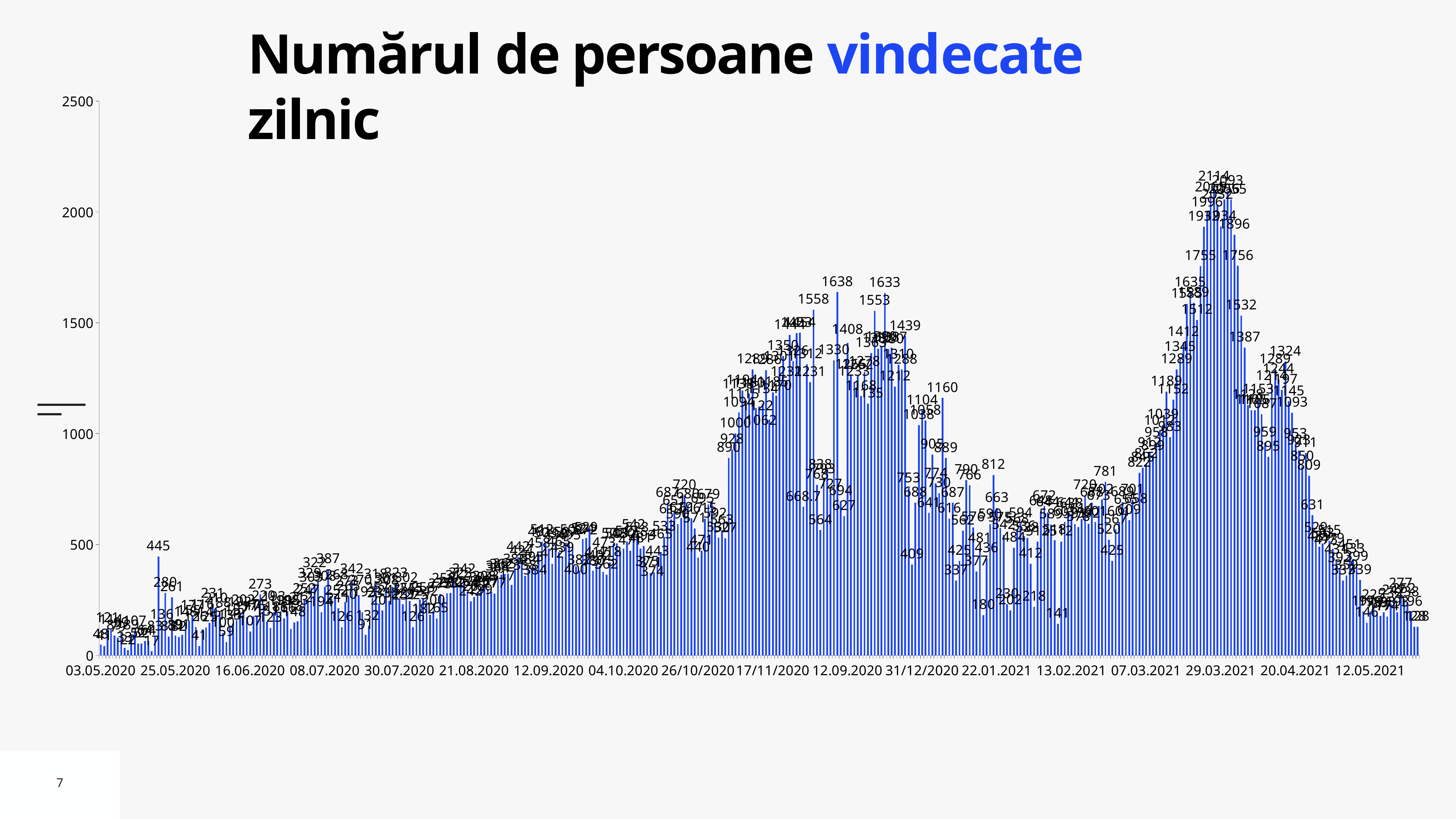
Is the value for the bar at 17/11/2020 greater or less than 1000? greater Which is larger: the peak value in late March 2021 (2114) or the peak value in December 2020 (1638)? 2114 (late March 2021) What is the highest daily value labelled on the chart? 2114 What is the difference between the peak value of 2114 and the earlier peak value of 1638? 476 What kind of chart is shown on the slide? bar chart What is the title of the chart? Numărul de persoane vindecate zilnic Is the value for the first bar at 03.05.2020 greater or less than 500? less Do the values generally rise or fall from 03.05.2020 to 17/11/2020? rise What is the highest value shown on the vertical axis? 2500 Is the value for the bar at 07.03.2021 greater or less than 500? greater Do the values generally rise or fall from 29.03.2021 to 12.05.2021? fall